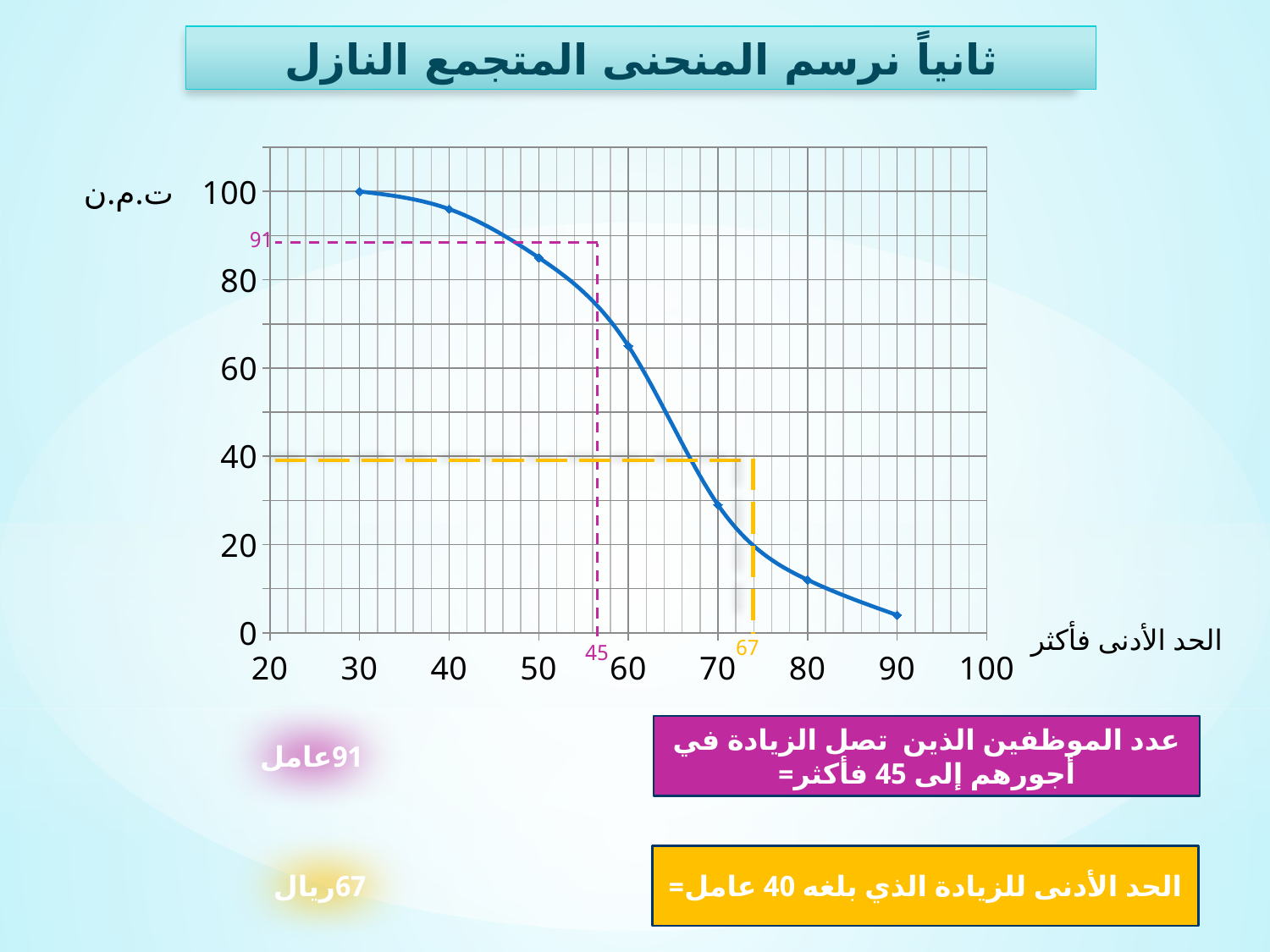
Is the value of the curve at x = 80 greater or less than 20? less Do the plotted values rise or fall as the x-axis value increases from 30 to 90? fall What is the value of the curve at x = 30? 100 Which has the larger value on the curve, x = 40 or x = 70? x = 40 Is the value of the curve at x = 70 greater or less than 40? less What is the label written next to the x axis? الحد الأدنى فأكثر How many data points are marked on the curve? 7 According to the dashed orange annotation, what x value corresponds to a cumulative value of 40? 67 What kind of chart is shown on the slide? line chart According to the dashed magenta annotation, what cumulative value corresponds to x = 45? 91 What is the highest tick value shown on the y axis? 100 Is the value of the curve at x = 50 greater or less than 80? greater